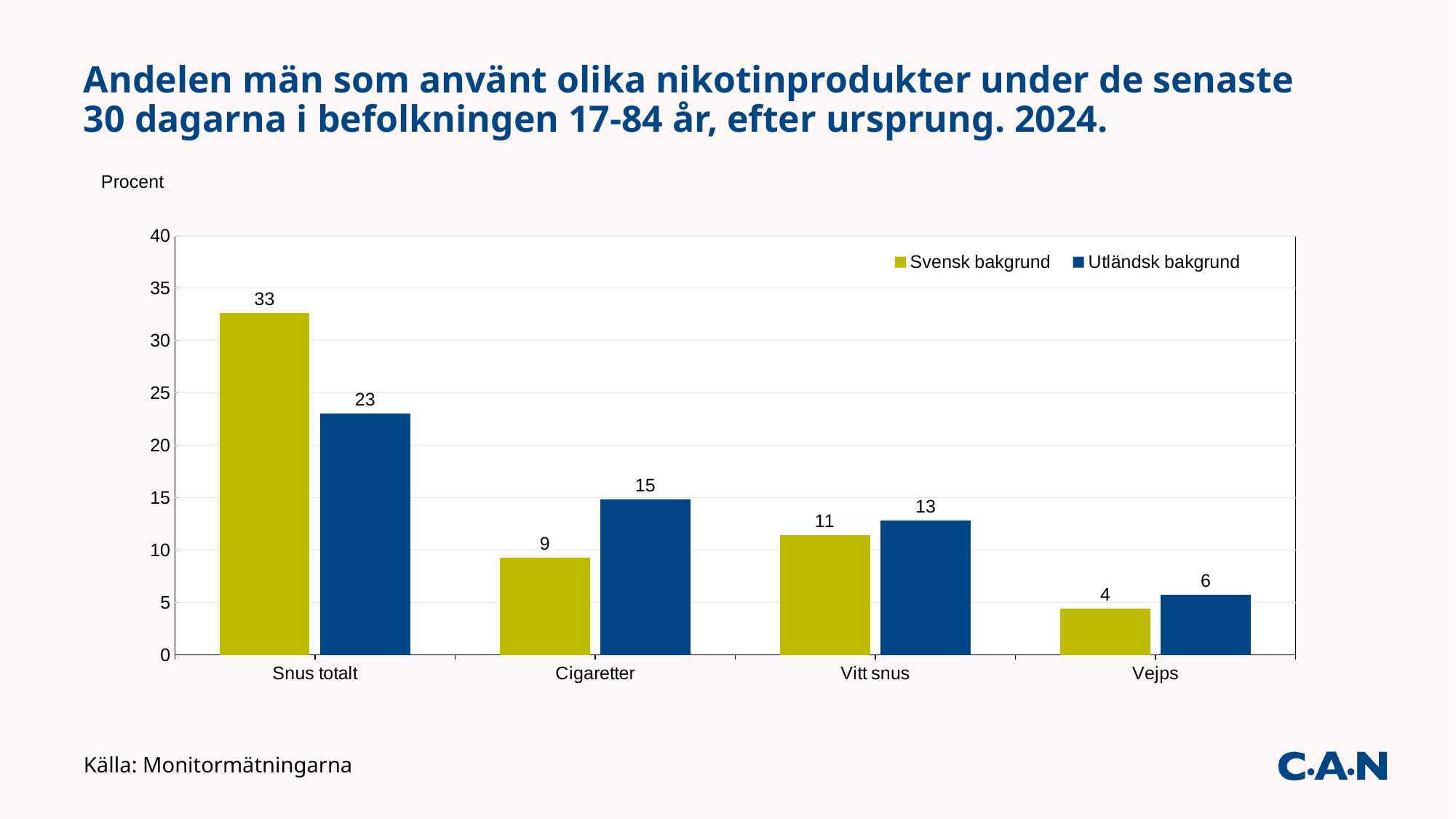
What kind of chart is shown on the slide? Bar chart What is the difference between the Svensk bakgrund and Utländsk bakgrund values for Snus totalt? 10 What is the value for Snus totalt in the Svensk bakgrund series? 33 What is the source cited at the bottom of the slide? Monitormätningarna How many categories are shown on the x axis? 4 What is the value for Vejps in the Svensk bakgrund series? 4 How many series does the legend list? 2 Which category has the highest value in the Utländsk bakgrund series? Snus totalt Is the Utländsk bakgrund value for Snus totalt greater or less than 20? greater For Vitt snus, which series has the larger value, Svensk bakgrund or Utländsk bakgrund? Utländsk bakgrund What is the value for Cigaretter in the Utländsk bakgrund series? 15 Which category has the lowest value in the Svensk bakgrund series? Vejps